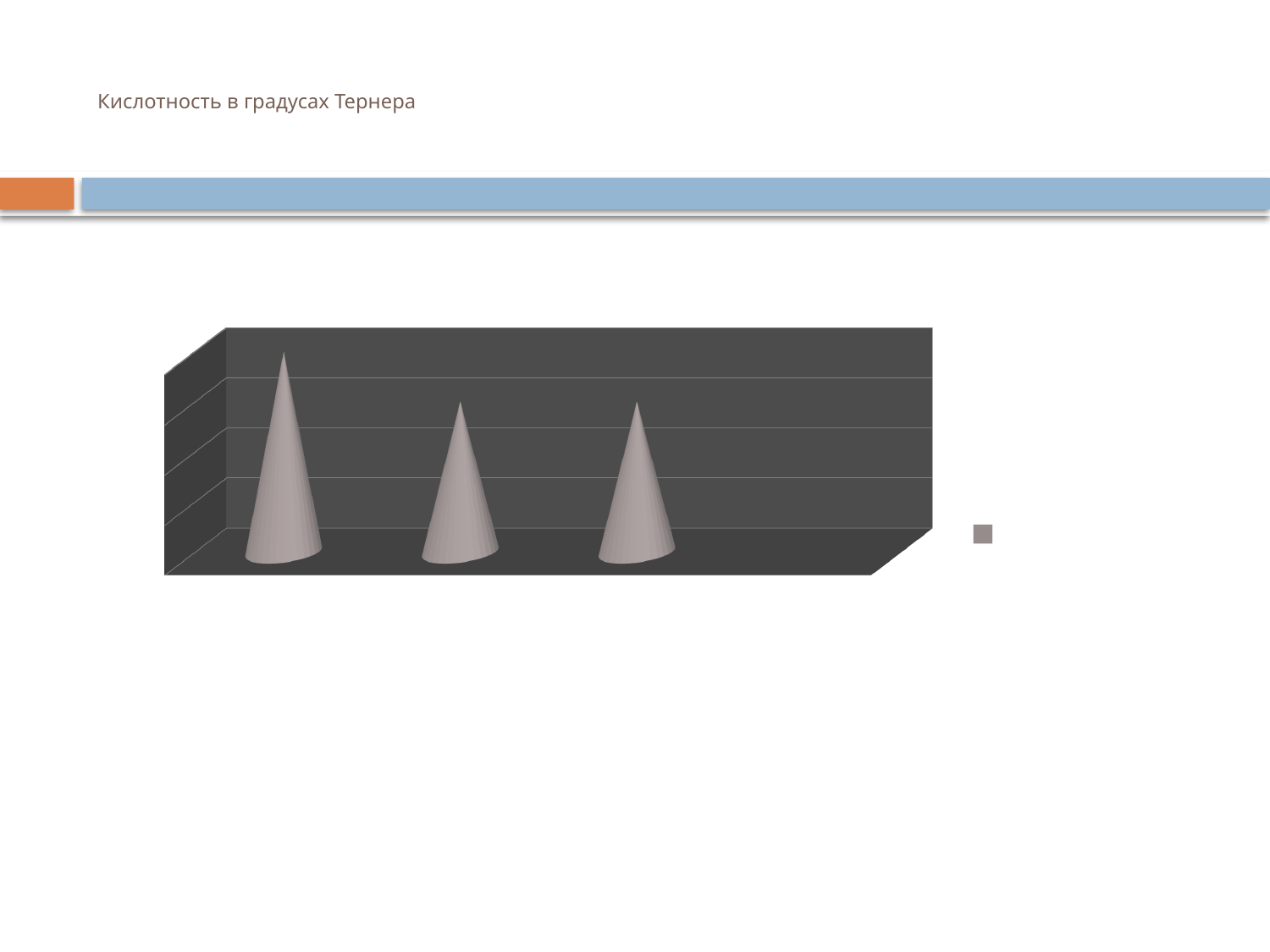
Which is taller in the chart, the leftmost bar or the middle bar? the leftmost bar How many series does the chart's legend list? 1 What kind of chart is shown on the slide? bar chart What shape are the bars drawn as in the chart? cones How many bars (cones) are plotted in the chart? 3 Which bar in the chart is the tallest: the leftmost, the middle, or the rightmost? the leftmost What title is shown at the top of the slide above the chart? Кислотность в градусах Тернера Which is taller in the chart, the leftmost bar or the rightmost bar? the leftmost bar